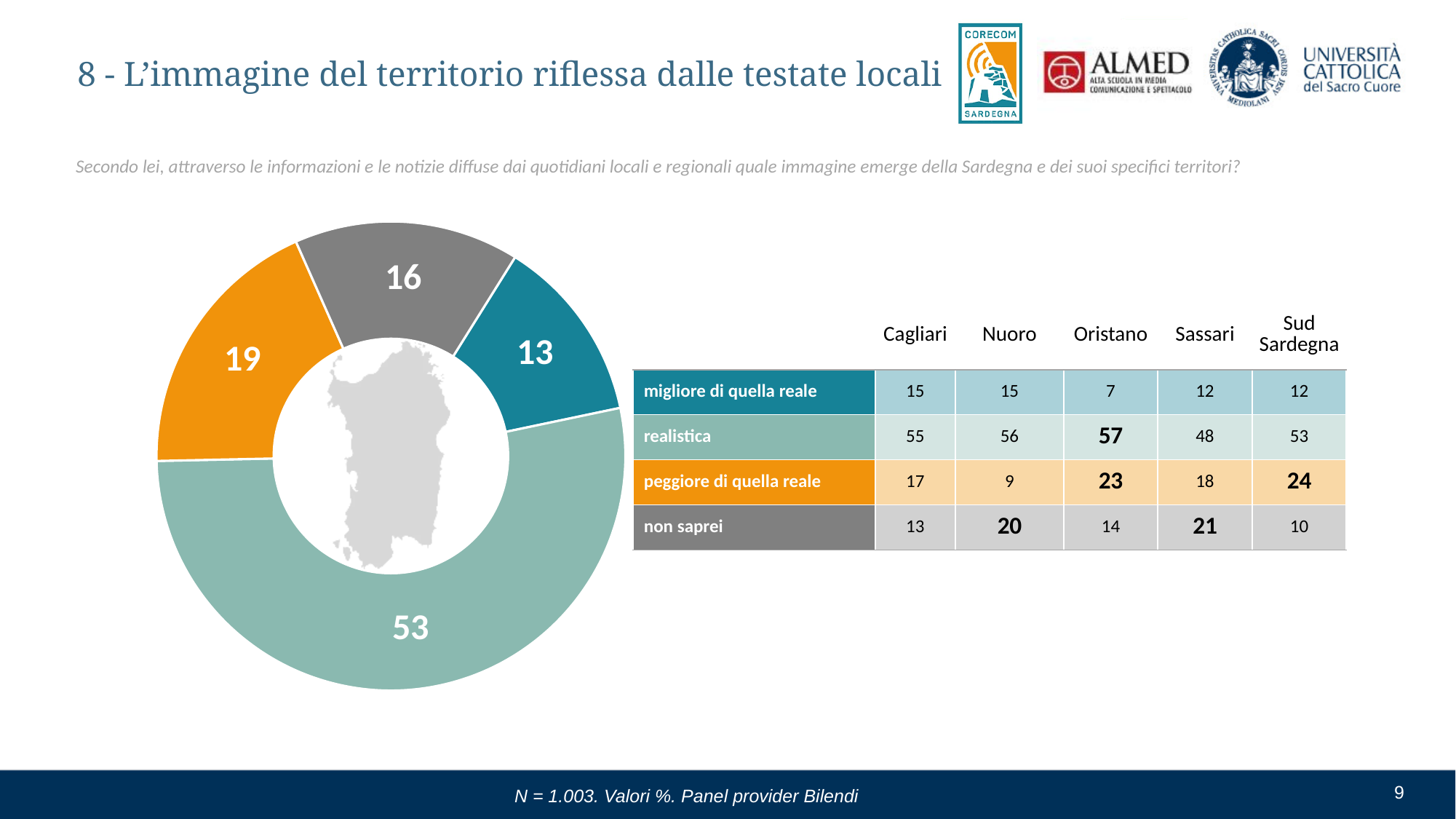
By how much does the orange slice exceed the grey slice in the donut chart? 3 What kind of chart is shown on the left of the slide? pie (donut) chart What is the value of the largest slice in the donut chart? 53 What value is shown on the grey slice of the donut chart? 16 What is the difference between the largest slice (53) and the smallest slice (13) in the donut chart? 40 What image is shown in the centre of the donut chart? a map of Sardinia How many slices does the donut chart have? 4 What is the difference between the largest slice (53) and the orange slice (19) in the donut chart? 34 What value is shown on the orange slice of the donut chart? 19 What is the value of the smallest slice in the donut chart? 13 Which slice of the donut chart is larger, the orange one or the grey one? the orange one (19) What value is shown on the dark teal slice of the donut chart? 13